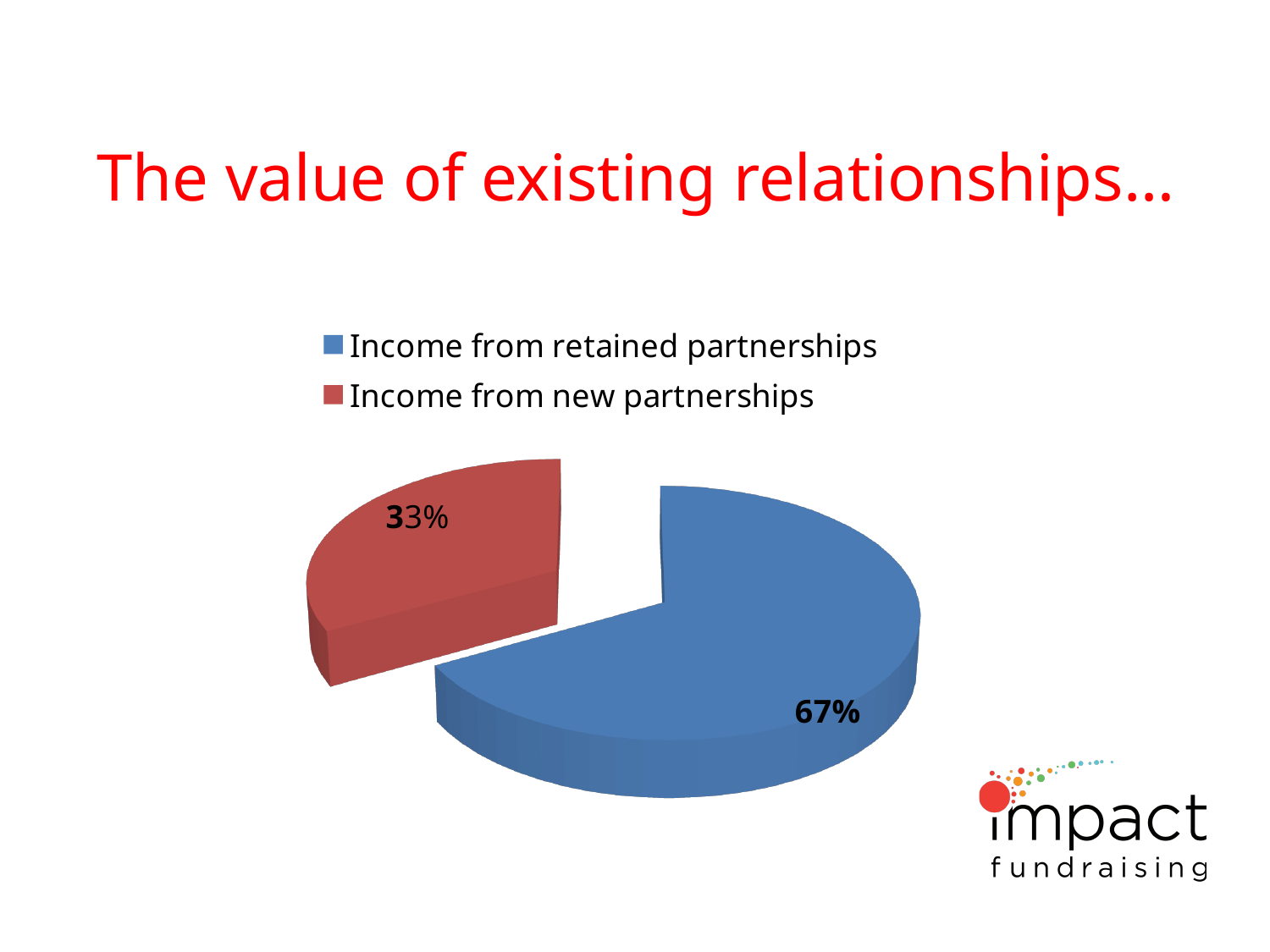
What is the title of the slide containing the pie chart? The value of existing relationships... What share of the pie is Income from new partnerships? 33% What share of the pie is Income from retained partnerships? 67% What is the difference in percentage points between Income from retained partnerships and Income from new partnerships? 34 How many slices does the pie chart have? 2 Which is larger: Income from retained partnerships or Income from new partnerships? Income from retained partnerships How many entries does the legend list? 2 Which slice of the pie is the smallest? Income from new partnerships Which slice of the pie is the largest? Income from retained partnerships What kind of chart is shown on the slide? pie chart What colour is the slice for Income from new partnerships? red